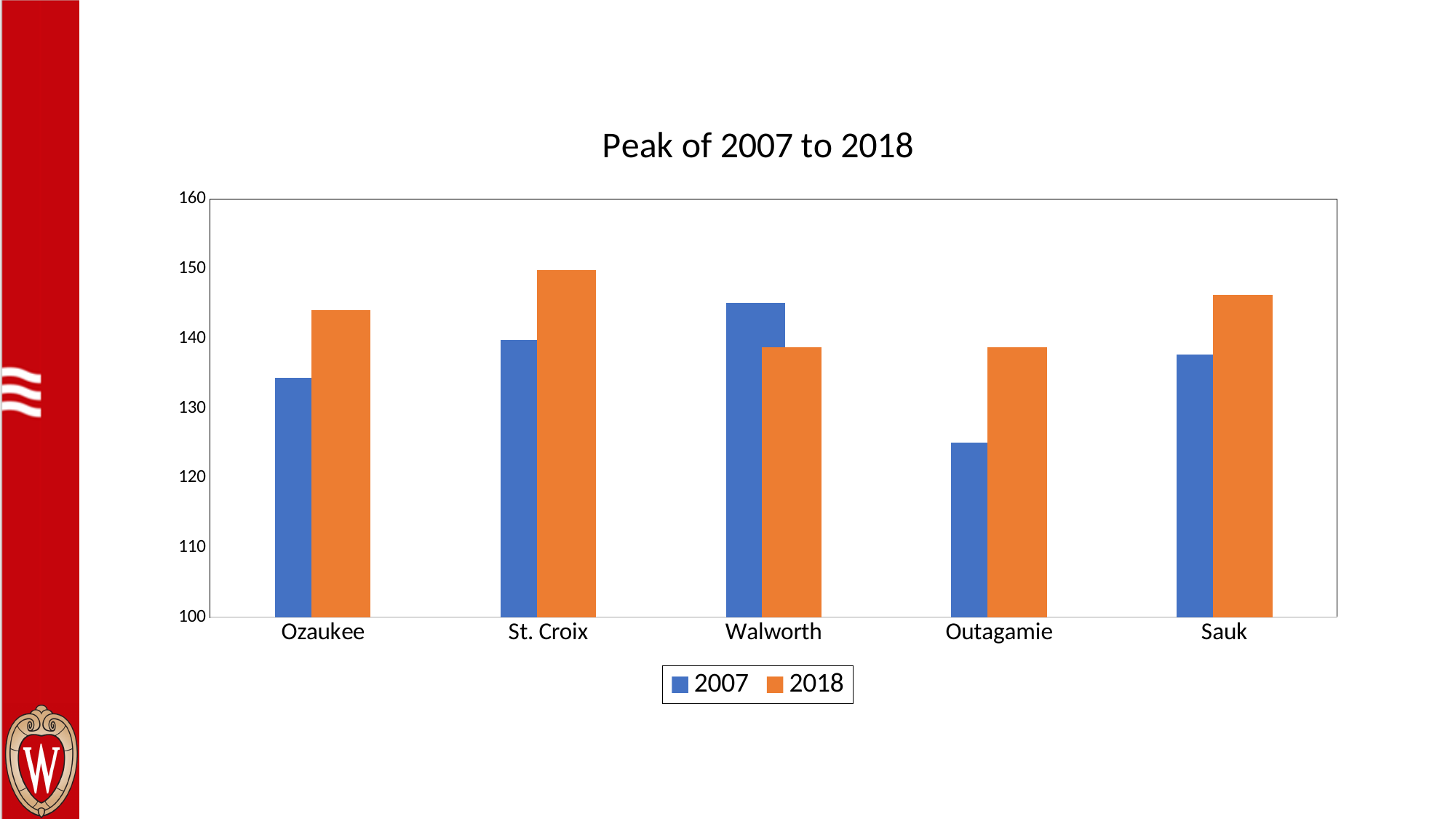
For Ozaukee, which series has the larger value, 2007 or 2018? 2018 Which county has the highest 2018 value? St. Croix Which county has the highest 2007 value? Walworth Which county has the lowest 2007 value? Outagamie Is the 2018 value for St. Croix greater or less than 140? greater How many counties are shown on the x axis? 5 Is the 2007 value for Outagamie greater or less than 130? less What type of chart is shown on the slide? bar chart How many series does the legend list? 2 Is the 2007 value for Walworth greater or less than 140? greater For Walworth, which series has the larger value, 2007 or 2018? 2007 What is the title of the chart? Peak of 2007 to 2018